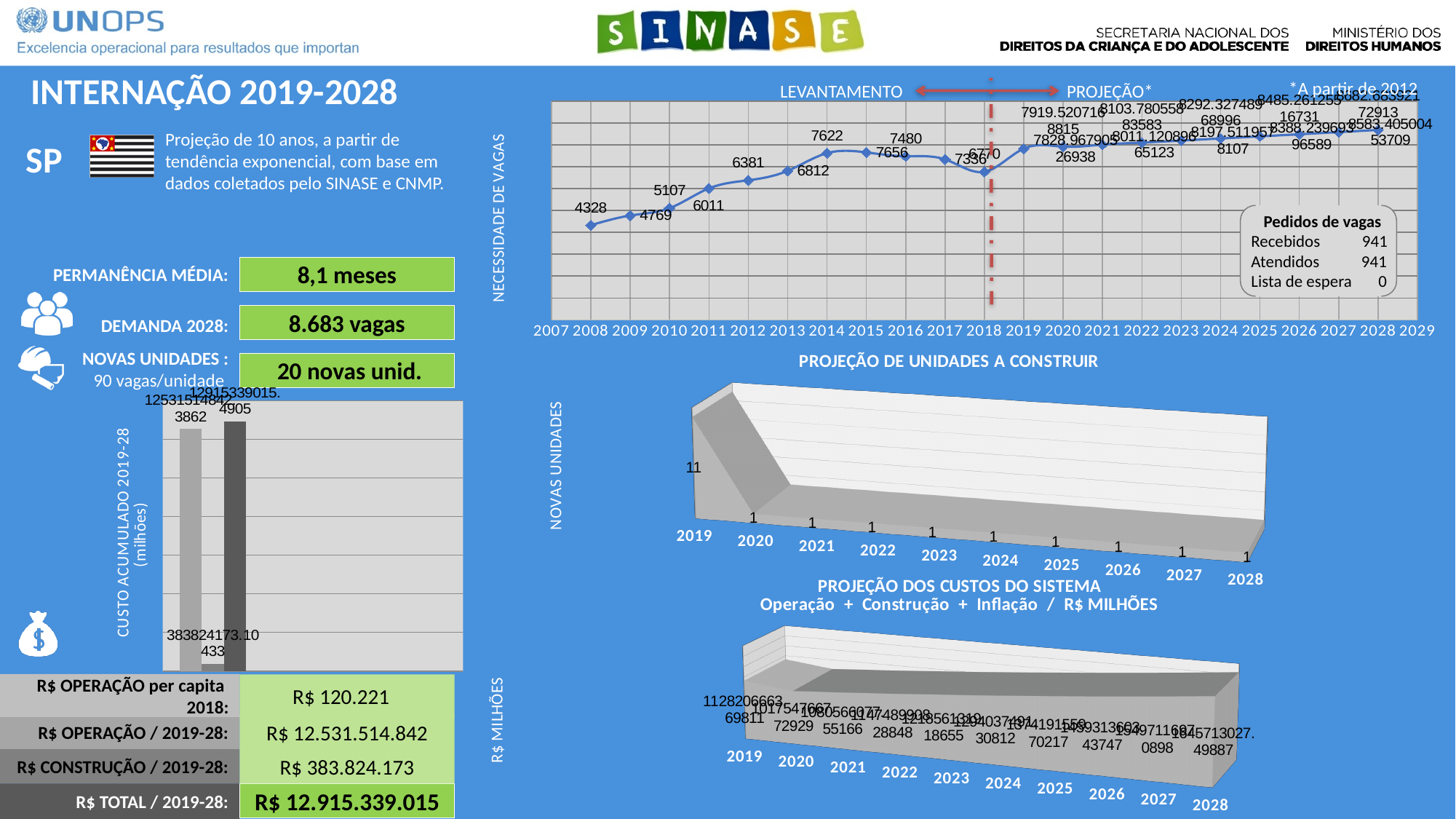
In the NECESSIDADE DE VAGAS line chart, do the values rise or fall from 2008 to 2014? rise What kind of chart is the top-right chart labelled NECESSIDADE DE VAGAS? line chart In the NECESSIDADE DE VAGAS line chart, what is the value for 2014? 7622 In the NECESSIDADE DE VAGAS line chart, what is the difference between the 2014 value and the 2008 value? 3294 In the NECESSIDADE DE VAGAS line chart, which is larger, the value for 2017 or the value for 2018? 2017 In the PROJEÇÃO DE UNIDADES A CONSTRUIR chart, how many years are shown on the x axis? 10 In the NECESSIDADE DE VAGAS line chart, what is the value for 2018? 6770 In the PROJEÇÃO DE UNIDADES A CONSTRUIR chart, what is the value for 2019? 11 In the NECESSIDADE DE VAGAS line chart, what is the value for 2008? 4328 In the NECESSIDADE DE VAGAS line chart, which year has the lowest value? 2008 In the NECESSIDADE DE VAGAS chart, what number is shown for 'Recebidos' in the 'Pedidos de vagas' box? 941